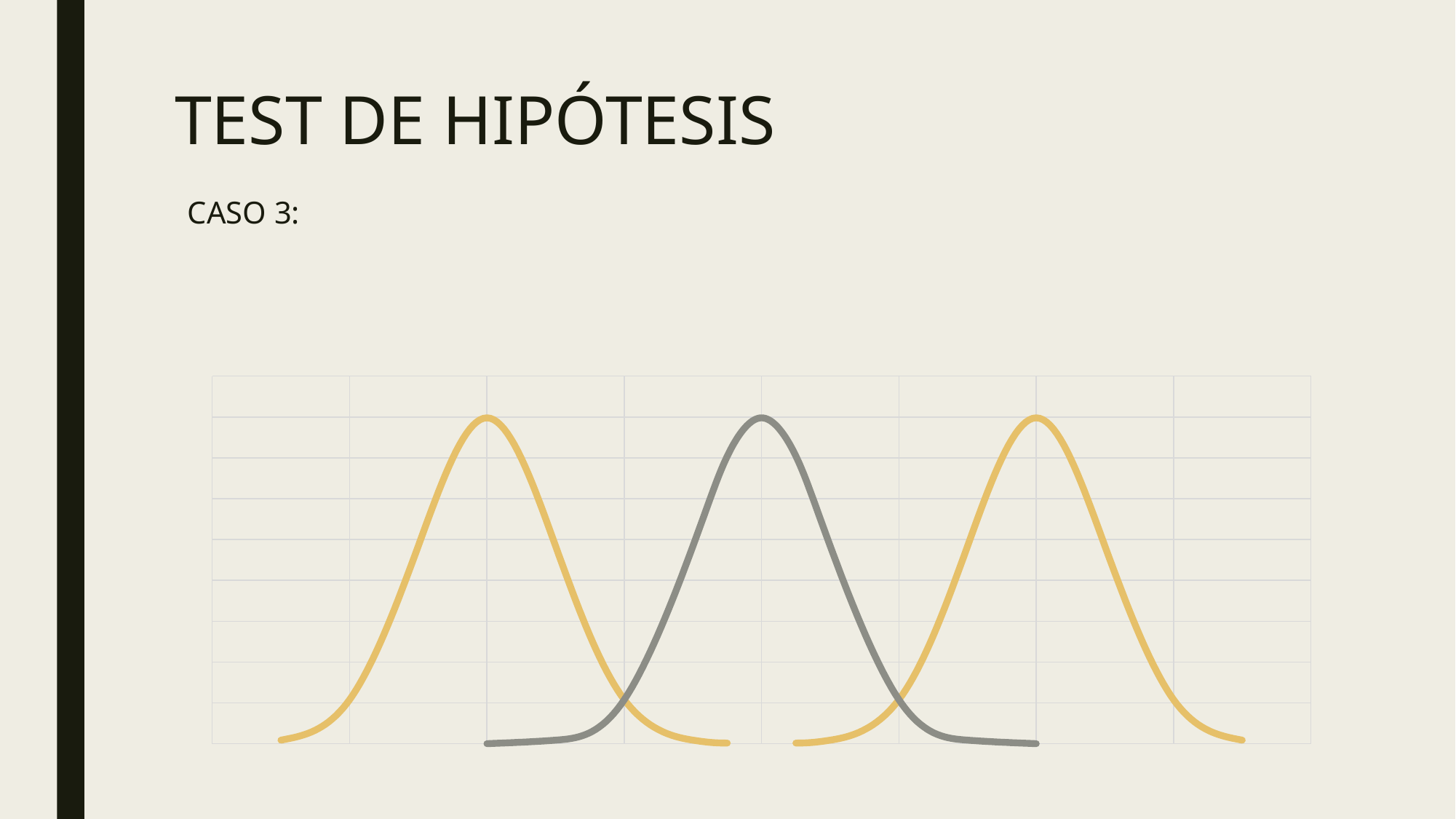
Does the chart display a legend? No What colour is the middle curve on the chart? gray What kind of chart is shown on the slide? line chart Are the three curves bell-shaped? Yes Does the gray curve rise and then fall along the x axis? Yes How many of the curves on the chart are yellow? 2 How many curves are plotted on the chart? 3